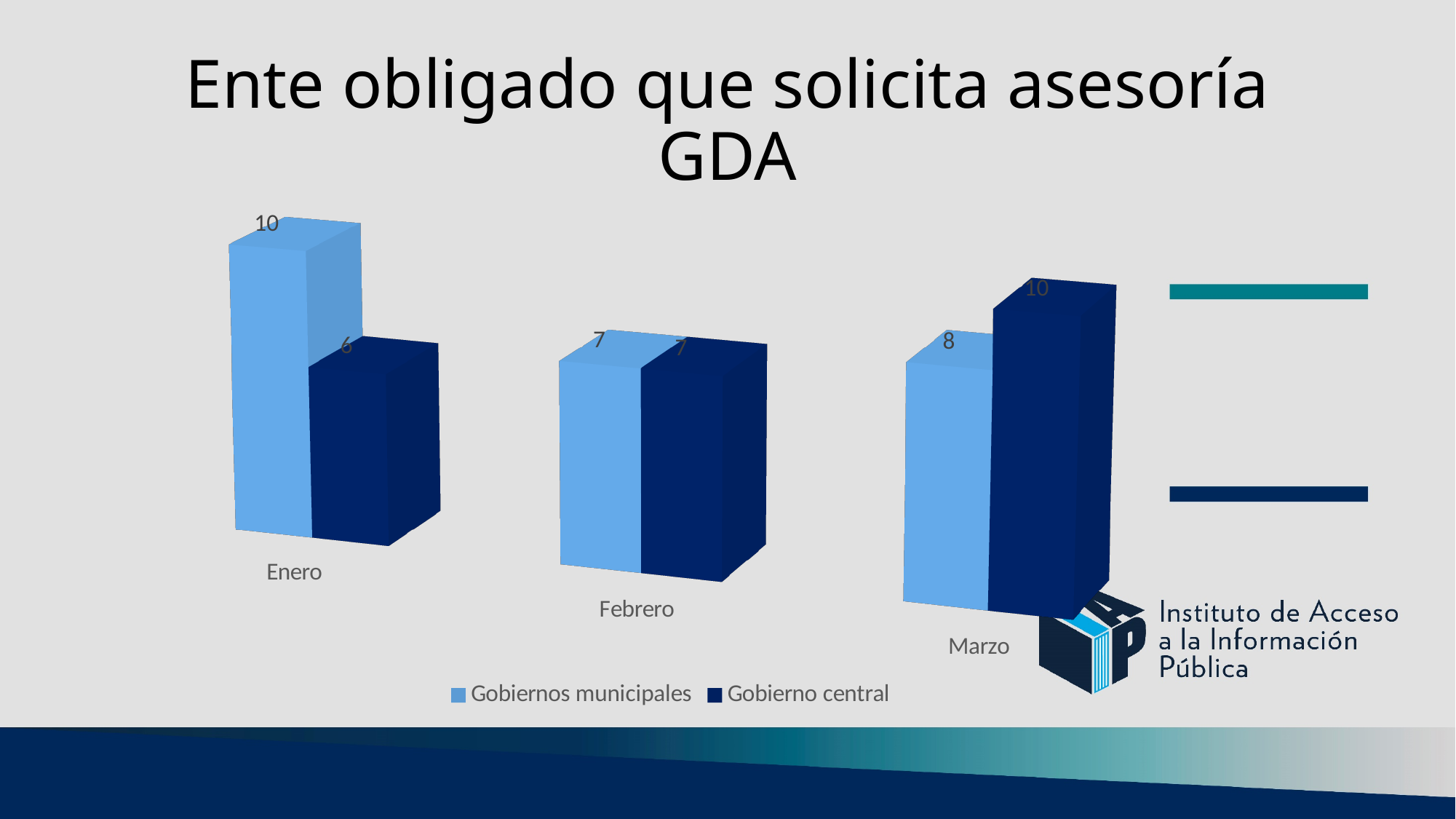
Which is larger in Marzo, Gobiernos municipales or Gobierno central? Gobierno central What is the value for Gobierno central in Enero? 6 How many series does the legend list? 2 What kind of chart is shown on the slide? Bar chart What is the difference between Gobiernos municipales and Gobierno central in Enero? 4 What is the value for Gobiernos municipales in Marzo? 8 How many months are shown on the x axis? 3 What is the value for Gobiernos municipales in Enero? 10 What is the value for Gobierno central in Marzo? 10 Does the value for Gobierno central rise or fall from Enero to Marzo? Rise In which month is the value for Gobierno central lowest? Enero In which month is the value for Gobiernos municipales highest? Enero